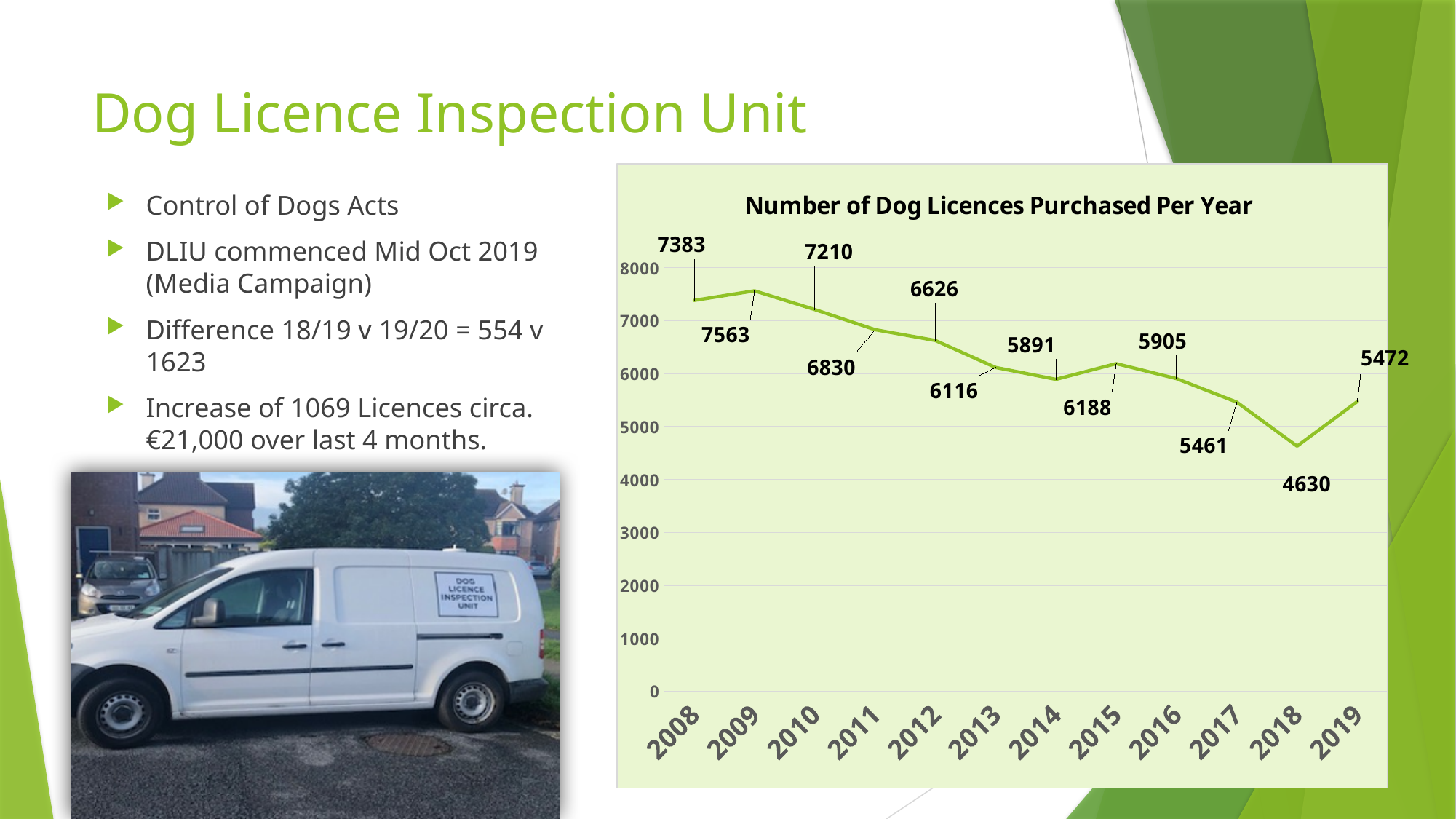
Which year had more dog licences purchased, 2014 or 2015? 2015 What is the difference between the number of dog licences purchased in 2008 and in 2019? 1911 Which year has the highest number of dog licences purchased? 2009 Which year has the lowest number of dog licences purchased? 2018 What is the number of dog licences purchased in 2008? 7383 What kind of chart is used to show the number of dog licences purchased per year? line chart How many years are shown on the x axis of the chart? 12 What is the difference between the number of dog licences purchased in 2017 and in 2018? 831 What is the number of dog licences purchased in 2018? 4630 Is the value for 2018 greater or less than 5000? less What is the number of dog licences purchased in 2019? 5472 What is the title of the chart? Number of Dog Licences Purchased Per Year